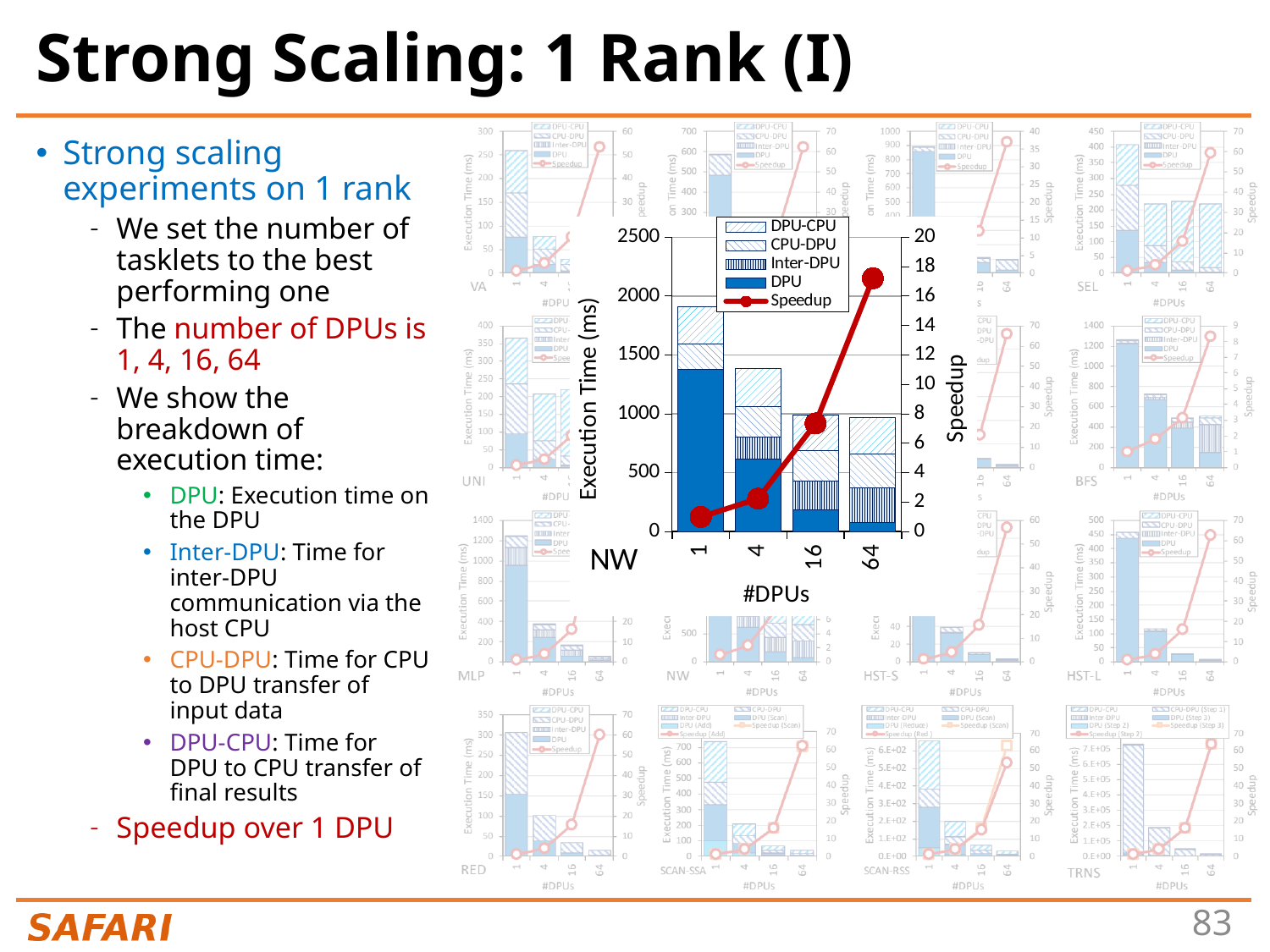
On the large NW chart, is the Speedup for 64 DPUs greater or less than 14? greater On the large NW chart, does the total execution time rise or fall as the number of DPUs increases from 1 to 64? Fall On the large NW chart, is the DPU execution time for 1 DPU greater or less than 1000 ms? greater On the large NW chart, how many series does the legend list? 5 On the large NW chart, does the Speedup line rise or fall as the number of DPUs increases? Rise On the large NW chart, how many #DPUs categories are shown on the x axis? 4 On the large NW chart, is the total execution time for 1 DPU greater or less than 2000 ms? less What is the label of the left vertical axis on the large NW chart? Execution Time (ms) What kind of chart is the large NW chart? Stacked bar chart with a speedup line On the large NW chart, which #DPUs category has the highest Speedup? 64